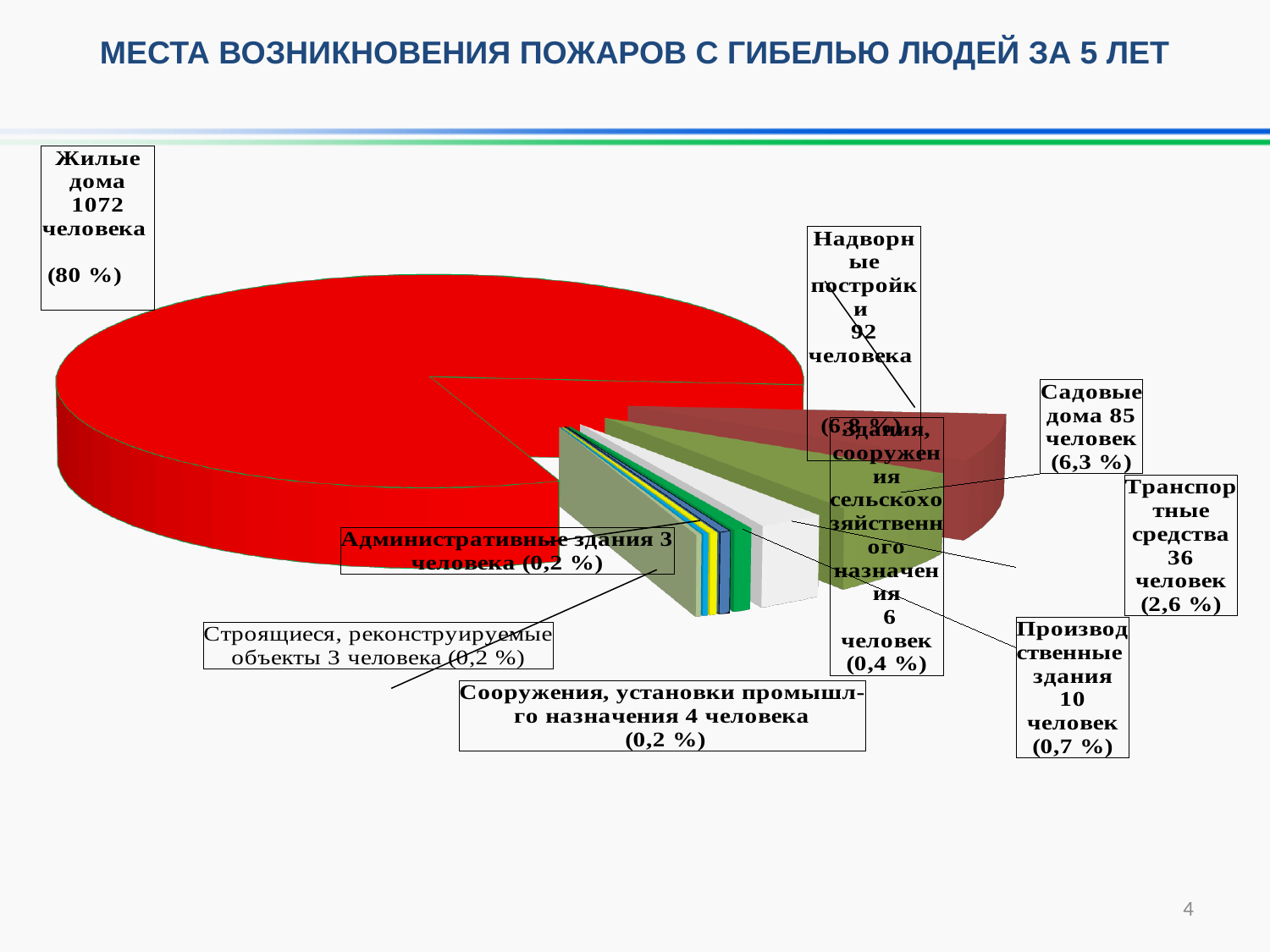
What is the difference in deaths between Надворные постройки (92) and Садовые дома (85)? 7 Which is larger: the number of deaths for Надворные постройки or for Садовые дома? Надворные постройки How many categories are labelled on the pie chart? 9 What kind of chart is shown on the slide? pie chart How many people died in fires in residential houses (Жилые дома) according to the chart? 1072 человека What percentage is shown for Транспортные средства? 2,6 % What share of the pie does the Жилые дома slice represent? 80 % Which category has the largest slice of the pie? Жилые дома What is the title of the slide containing the chart? МЕСТА ВОЗНИКНОВЕНИЯ ПОЖАРОВ С ГИБЕЛЬЮ ЛЮДЕЙ ЗА 5 ЛЕТ How many people died in fires in production buildings (Производственные здания)? 10 человек How many people died in fires in garden houses (Садовые дома)? 85 человек How many people died in fires at Сооружения, установки промышленного назначения? 4 человека